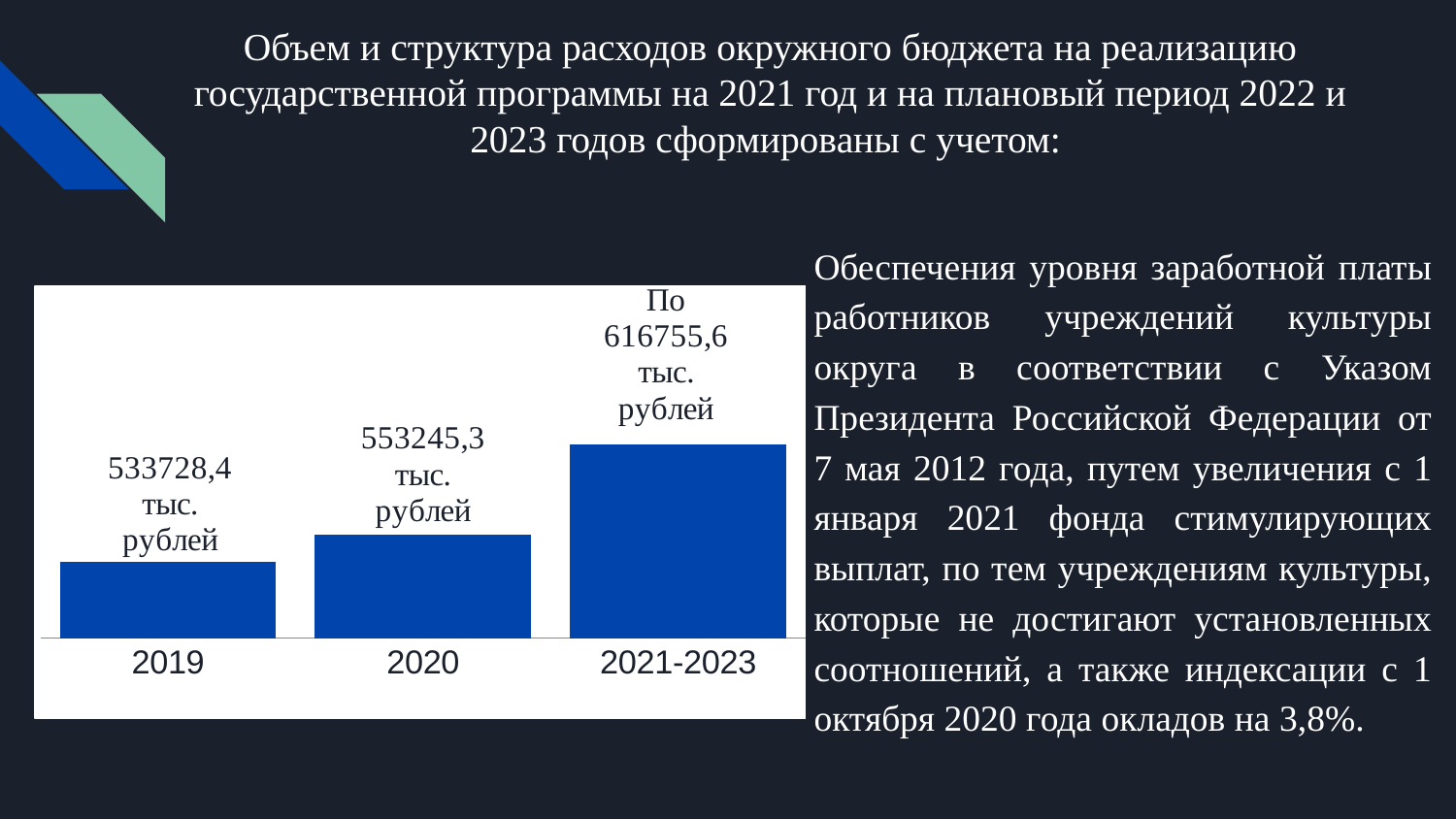
How many categories are shown on the x axis of the chart? 3 What is the difference between the values for 2020 and 2019? 19516,9 тыс. рублей What is the value shown for 2021-2023? 616755,6 тыс. рублей What is the value shown for 2019? 533728,4 тыс. рублей What type of chart is shown on the slide? bar chart What is the value shown for 2020? 553245,3 тыс. рублей What is the difference between the values for 2021-2023 and 2019? 83027,2 тыс. рублей Do the values rise or fall from 2019 to 2021-2023? rise Which category has the lowest value? 2019 Which is larger, the value for 2019 or the value for 2020? 2020 What is the difference between the values for 2021-2023 and 2020? 63510,3 тыс. рублей Which category has the highest value? 2021-2023